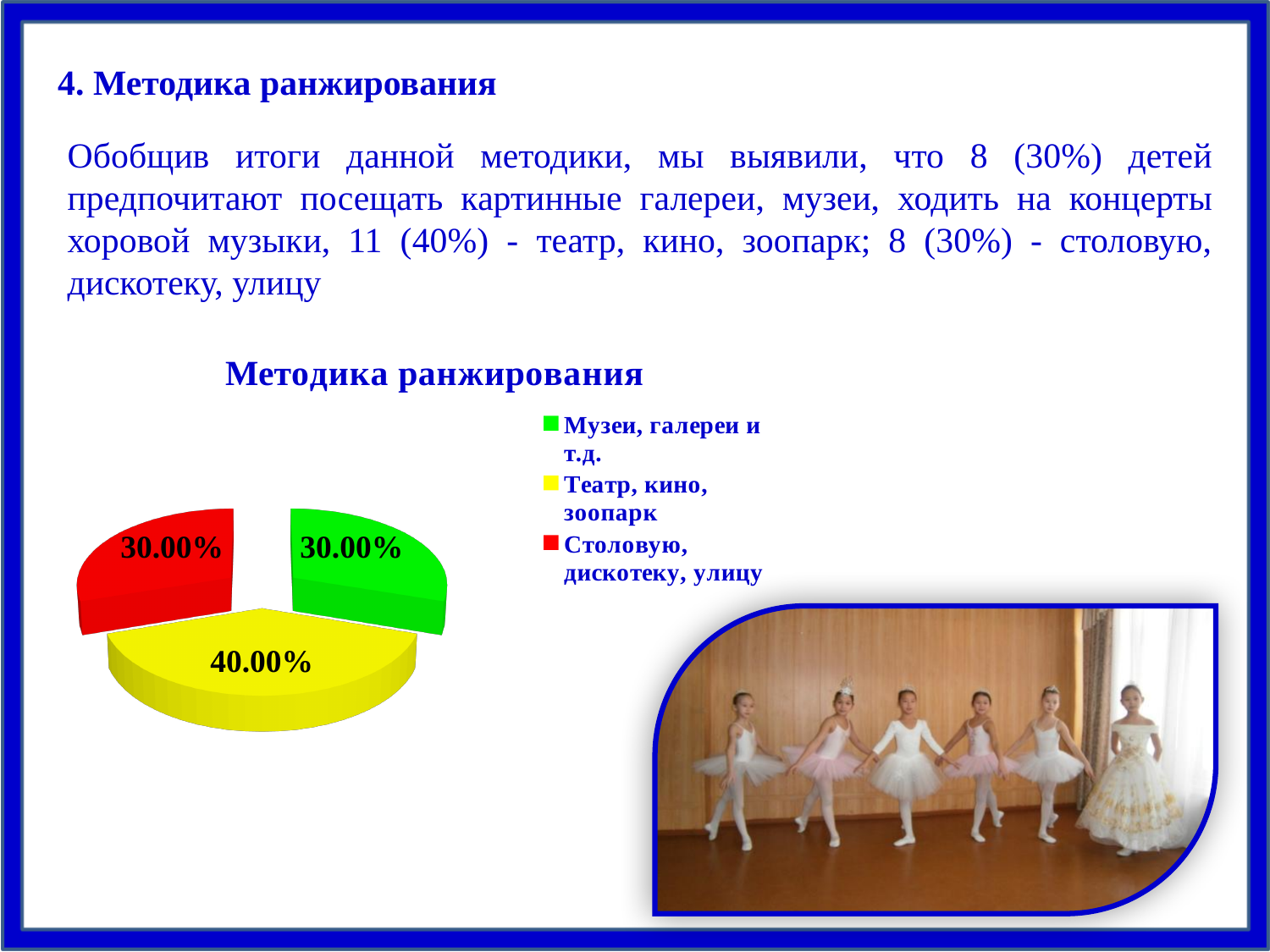
What share of the pie does "Театр, кино, зоопарк" take? 40.00% What share of the pie does "Музеи, галереи и т.д." take? 30.00% Which colour represents "Столовую, дискотеку, улицу" in the pie chart? red Which is larger: the slice for "Театр, кино, зоопарк" or the slice for "Музеи, галереи и т.д."? Театр, кино, зоопарк What kind of chart is shown on the slide? pie chart How many slices does the pie chart have? 3 What share of the pie does "Столовую, дискотеку, улицу" take? 30.00% Which category has the largest slice of the pie? Театр, кино, зоопарк What is the difference between the share for "Театр, кино, зоопарк" and the share for "Столовую, дискотеку, улицу"? 10.00% How many entries does the legend of the pie chart list? 3 What is the title of the chart? Методика ранжирования